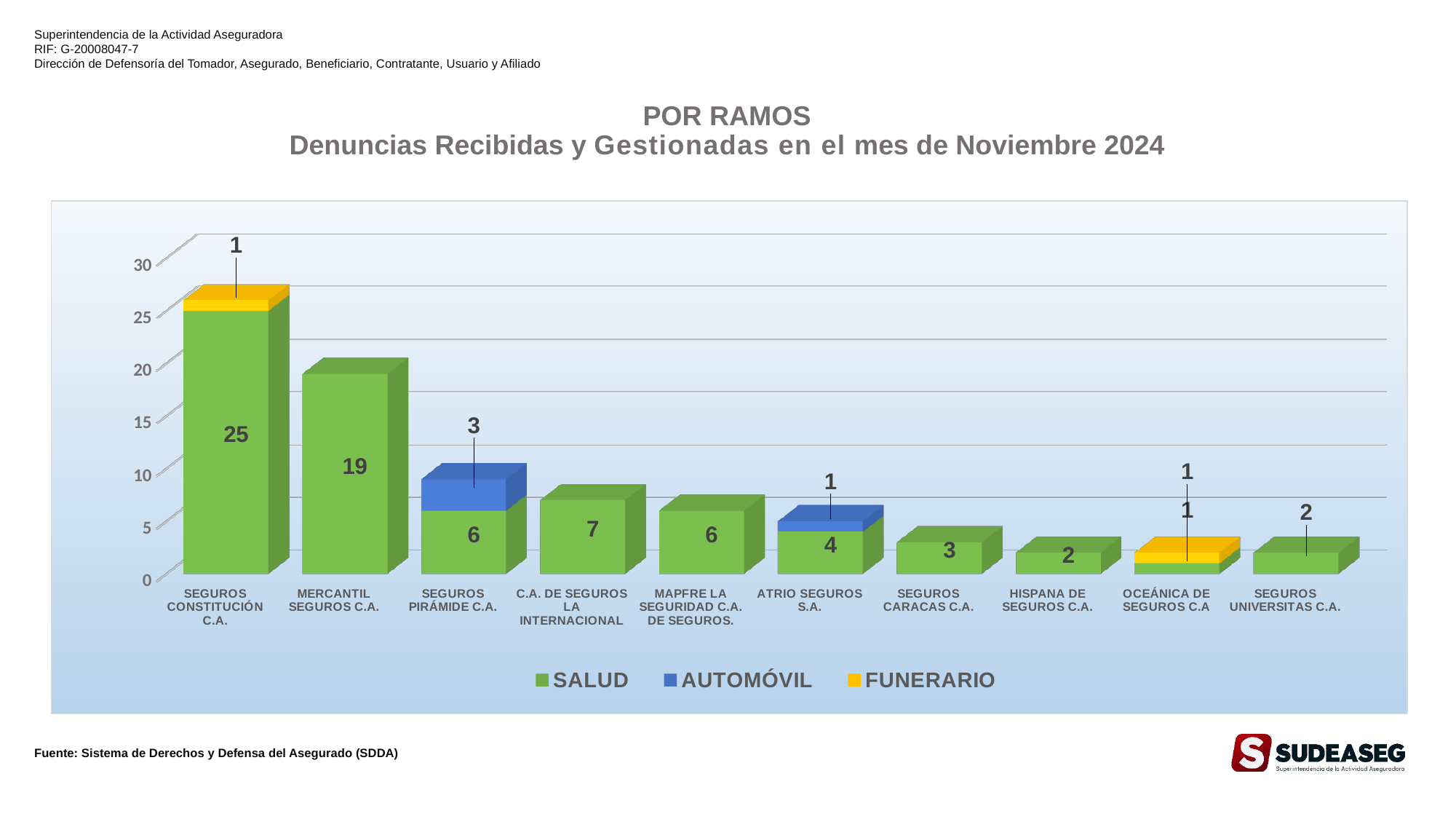
What type of chart is shown on the slide? bar chart Which is larger, the SALUD value for C.A. DE SEGUROS LA INTERNACIONAL or for ATRIO SEGUROS S.A.? C.A. DE SEGUROS LA INTERNACIONAL What is the total of the stacked bar for SEGUROS PIRÁMIDE C.A.? 9 Which series is shown in yellow in the legend? FUNERARIO How many series does the legend list? 3 How many insurance companies (categories) are shown on the x axis? 10 What is the SALUD value for SEGUROS CONSTITUCIÓN C.A.? 25 What is the SALUD value for MERCANTIL SEGUROS C.A.? 19 What is the difference between the SALUD values of SEGUROS CONSTITUCIÓN C.A. and MERCANTIL SEGUROS C.A.? 6 Which company has the highest SALUD value? SEGUROS CONSTITUCIÓN C.A. What is the AUTOMÓVIL value for SEGUROS PIRÁMIDE C.A.? 3 What is the FUNERARIO value for OCEÁNICA DE SEGUROS C.A? 1